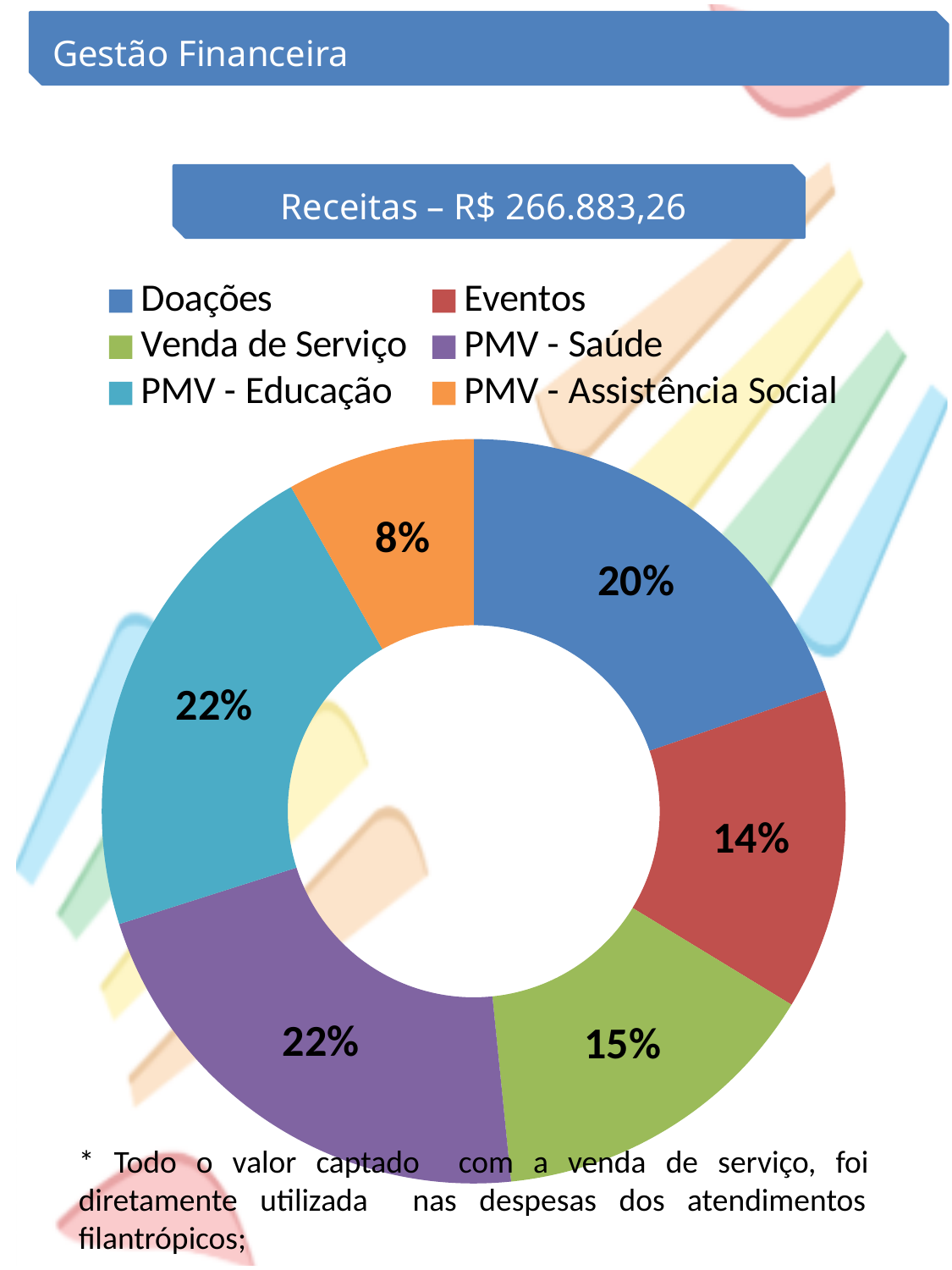
Which is larger, the share for Doações or the share for Eventos? Doações What share does Venda de Serviço represent? 15% What share of receitas comes from Doações? 20% What kind of chart is shown on the slide? Pie chart (doughnut) What total value of receitas is stated in the chart heading? R$ 266.883,26 How many categories does the chart show? 6 What percentage is shown for PMV - Assistência Social? 8% What percentage is shown for Eventos? 14% What is the difference in percentage points between PMV - Saúde and PMV - Assistência Social? 14 What is the difference in percentage points between Venda de Serviço and Eventos? 1 Which category has the smallest share of the chart? PMV - Assistência Social What share is shown for PMV - Educação? 22%